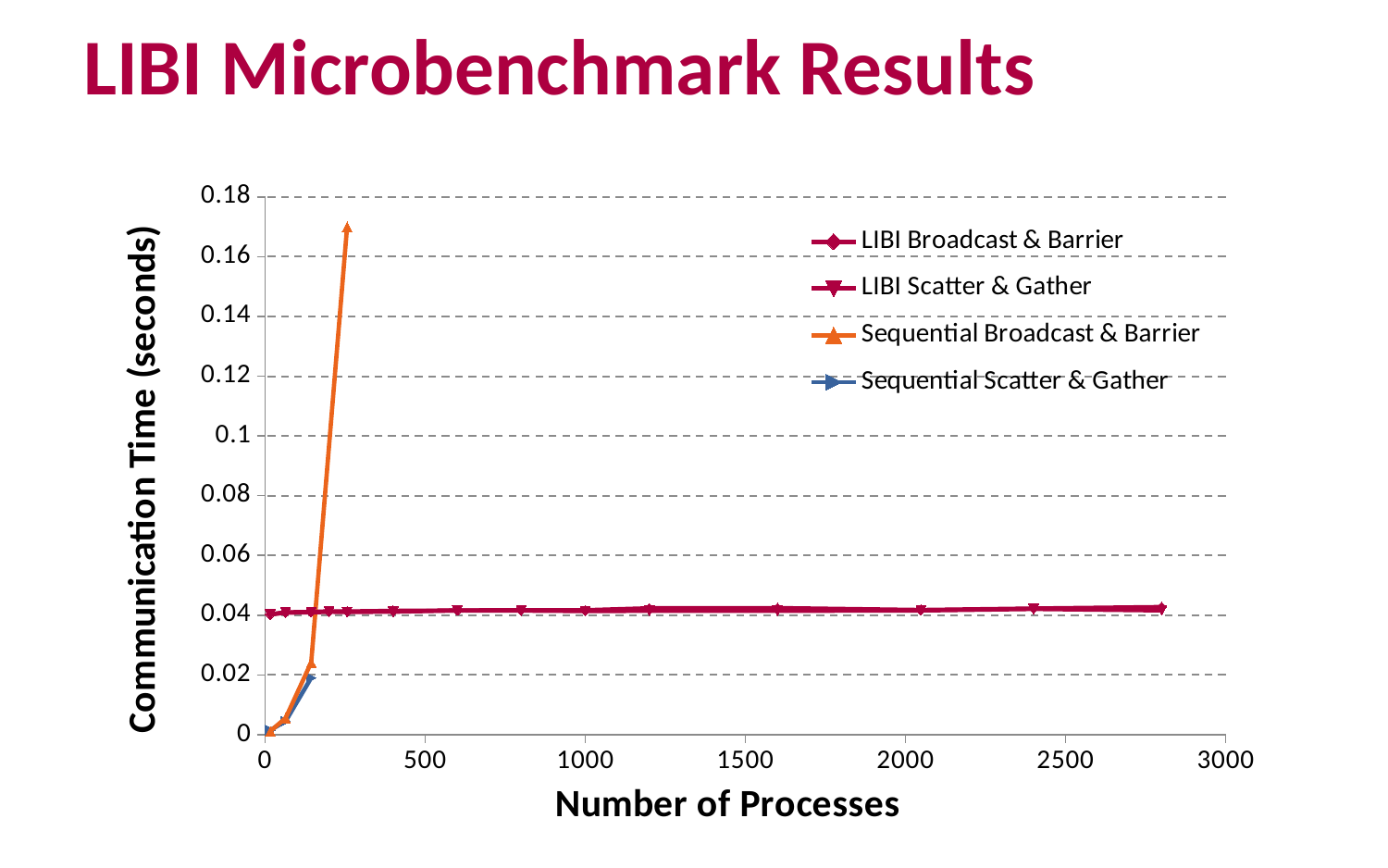
Does the Sequential Broadcast & Barrier series rise or fall as the number of processes increases? rise Is the value for LIBI Broadcast & Barrier at 2800 processes greater or less than 0.06? less Is the value for Sequential Scatter & Gather at about 150 processes greater or less than 0.04? less How many series does the legend list? 4 Is the highest value of the Sequential Broadcast & Barrier series greater or less than 0.16? greater What is the title of the chart on the slide? LIBI Microbenchmark Results Which series reaches the highest communication time on the chart? Sequential Broadcast & Barrier What is the label of the y axis? Communication Time (seconds) What kind of chart is shown on the slide? Line chart At around 250 processes, which is larger: the Sequential Broadcast & Barrier value or the LIBI Broadcast & Barrier value? Sequential Broadcast & Barrier